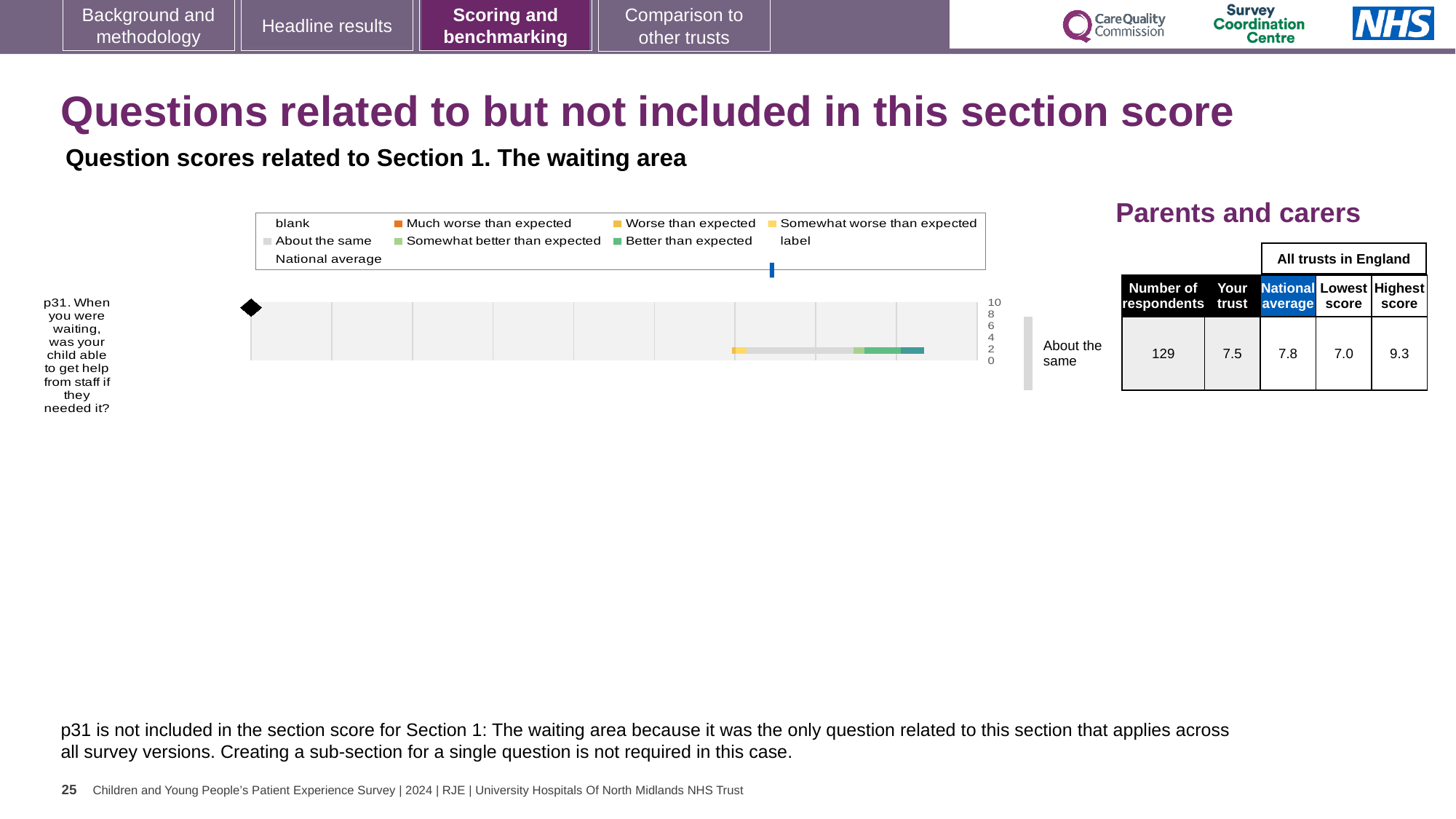
Which question is plotted in the chart? p31. When you were waiting, was your child able to get help from staff if they needed it? What comparison category is shown for p31 next to the chart? About the same In the table, what is the highest score among all trusts in England for p31? 9.3 What colour in the legend represents 'Much worse than expected'? orange How many questions are plotted in the chart? 1 What is the difference between the national average (7.8) and the 'Your trust' score (7.5) for p31? 0.3 What kind of chart is used to show the p31 question score? bar chart Which is larger for p31: the 'Your trust' score or the national average? National average In the table, what is the 'Your trust' score for p31? 7.5 In the table, how many respondents answered p31? 129 In the table, what is the national average score for p31? 7.8 In the table, what is the lowest score among all trusts in England for p31? 7.0